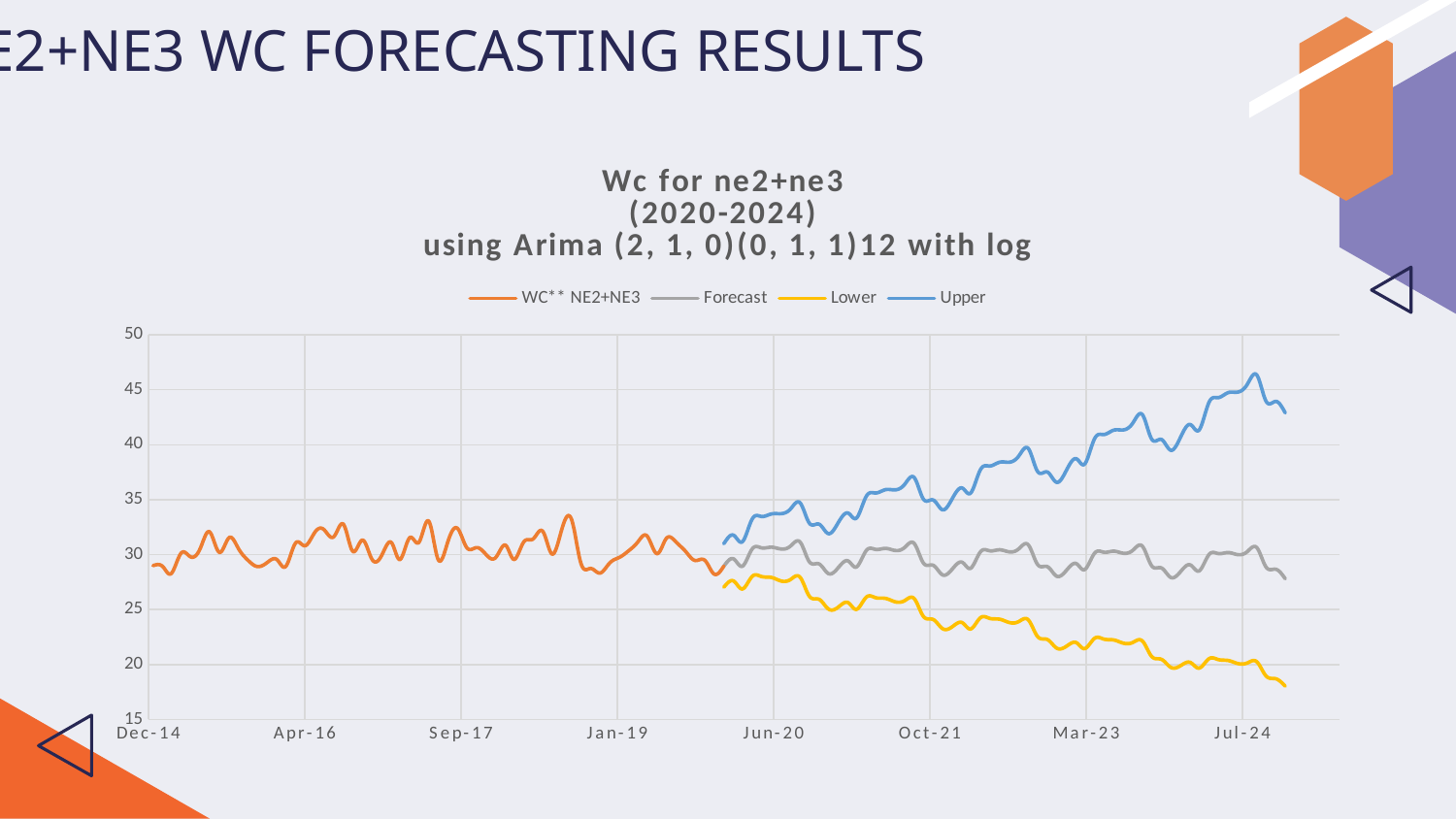
What colour is the Upper line? blue Does the Upper series rise or fall from Jun-20 to Jul-24? rise What kind of chart is shown on the slide? line chart Does the Lower series rise or fall from Jun-20 to Jul-24? fall Is the value of the Upper series at Jul-24 greater or less than 40? greater At Mar-23, which is larger: the Upper series or the Forecast series? Upper Is the value of the WC** NE2+NE3 series at Dec-14 greater or less than 25? greater What are the four series listed in the legend? WC** NE2+NE3, Forecast, Lower, Upper How many date labels are shown on the x axis? 8 How many series does the legend list? 4 Is the value of the Lower series at Jul-24 greater or less than 25? less